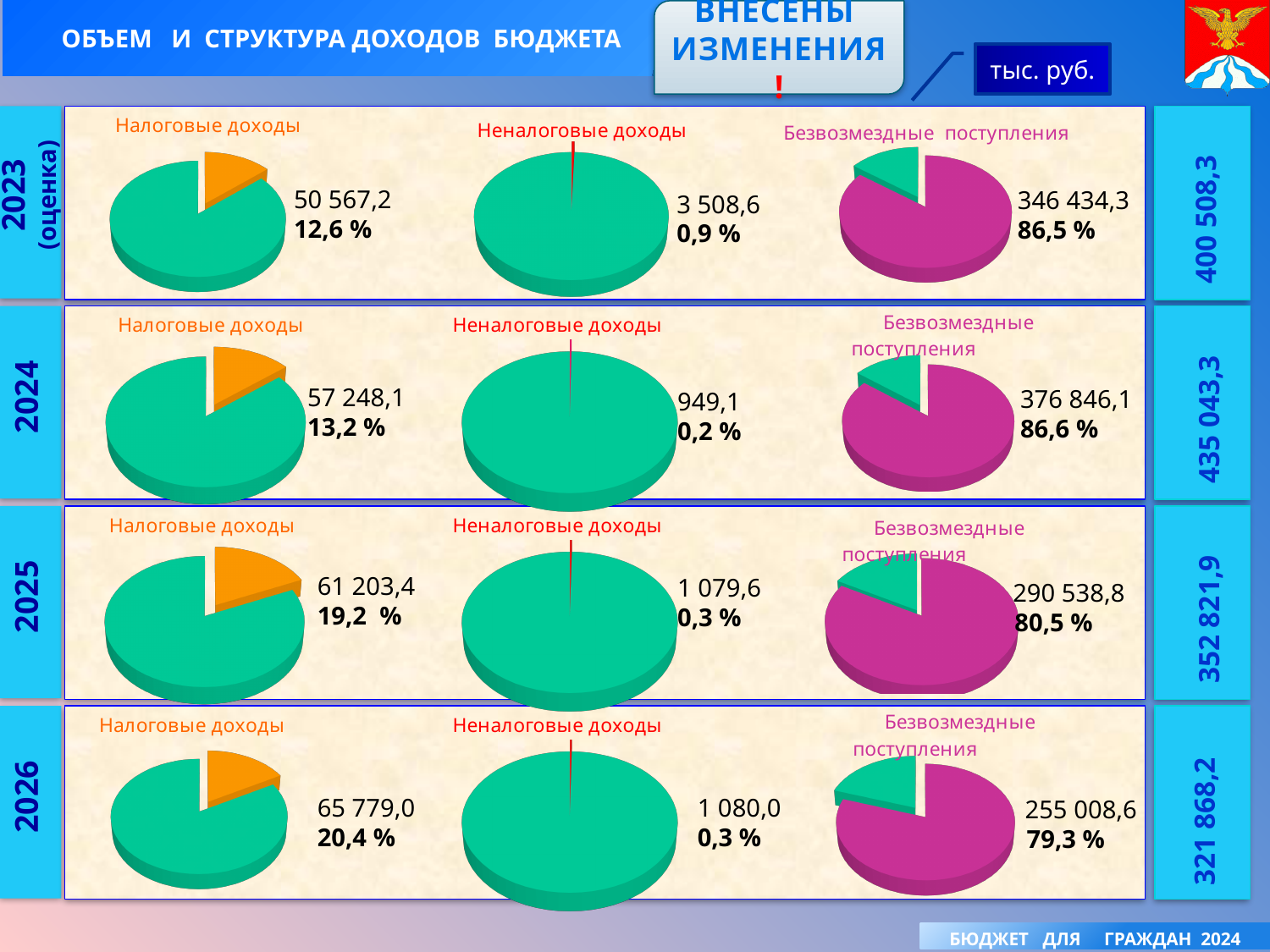
In the 2025 row, what value is shown for Неналоговые доходы? 1 079,6 Which year's Налоговые доходы pie shows the highest value: 2023, 2024, 2025 or 2026? 2026 Which is larger: the Налоговые доходы value for 2025 or for 2024? 2025 Which year's Неналоговые доходы pie shows the lowest value? 2024 What total is shown on the right for the 2025 row? 352 821,9 What kind of charts are shown on the slide? Pie charts What is the difference between the Безвозмездные поступления values for 2024 and 2025? 86 307,3 In the 2026 row, what share of the pie does Налоговые доходы represent? 20,4 % Do the Безвозмездные поступления percentages rise or fall from 2024 to 2026? Fall How many pie charts are on the slide? 12 In the 2023 (оценка) row, what value is shown for Налоговые доходы? 50 567,2 In the 2024 row, what share of the pie does Безвозмездные поступления represent? 86,6 %